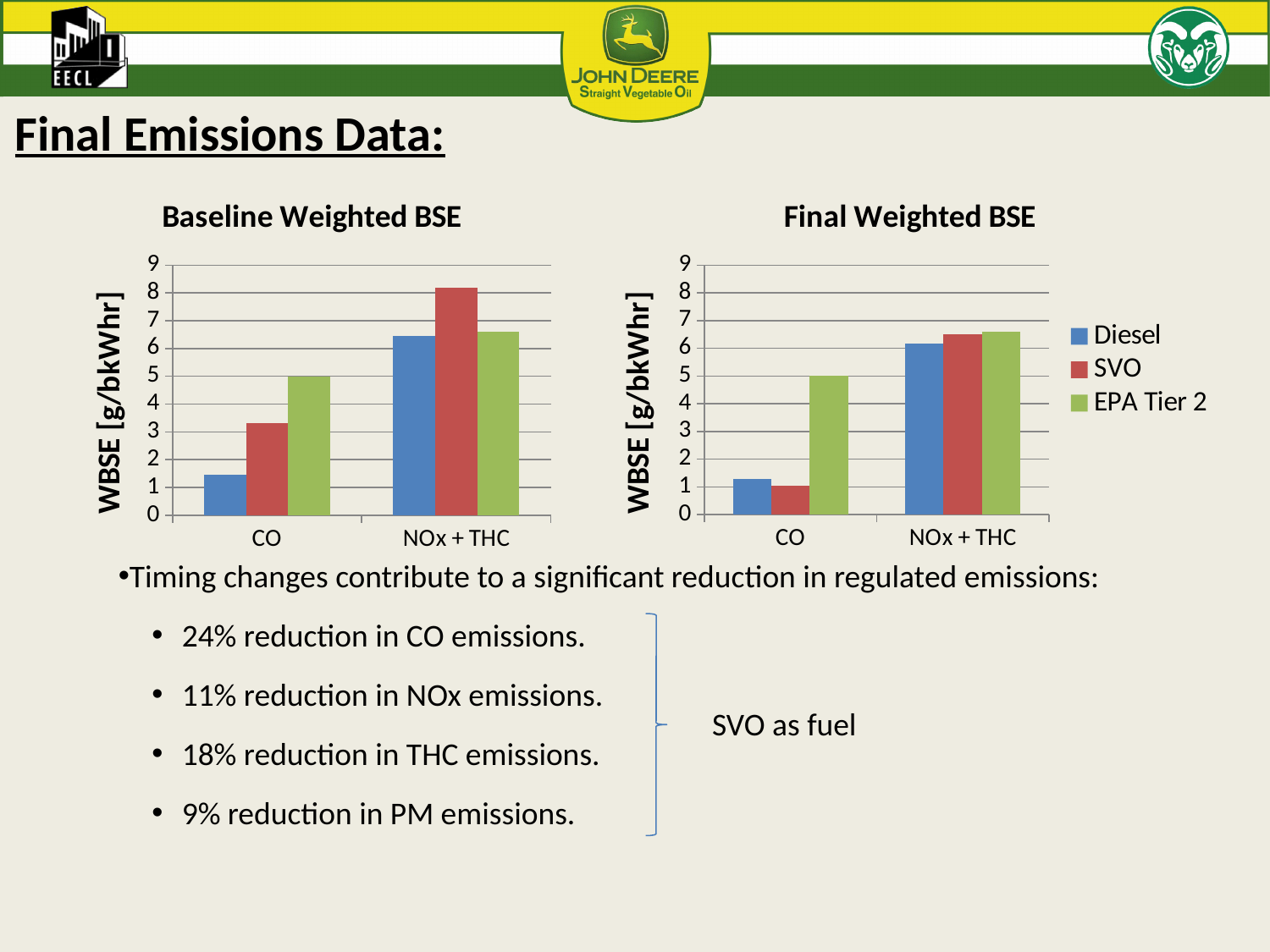
In the Baseline Weighted BSE chart, which series has the highest value for NOx + THC? SVO In the Baseline Weighted BSE chart, is the SVO value for NOx + THC greater or less than 7? greater In the Baseline Weighted BSE chart, which series has the lowest value for CO? Diesel In the Baseline Weighted BSE chart, which is larger for CO: the SVO value or the Diesel value? SVO What kind of chart is the Baseline Weighted BSE chart? bar chart What is the y-axis label on the Final Weighted BSE chart? WBSE [g/bkWhr] In the Baseline Weighted BSE chart, is the Diesel value for CO greater or less than 2? less How many categories are shown on the x axis of the Final Weighted BSE chart? 2 In the Final Weighted BSE chart, which series has the highest value for CO? EPA Tier 2 How many series does the legend on the Final Weighted BSE chart list? 3 In the Final Weighted BSE chart, is the Diesel value for NOx + THC greater or less than 5? greater In the Baseline Weighted BSE chart, which series has the highest value for CO? EPA Tier 2